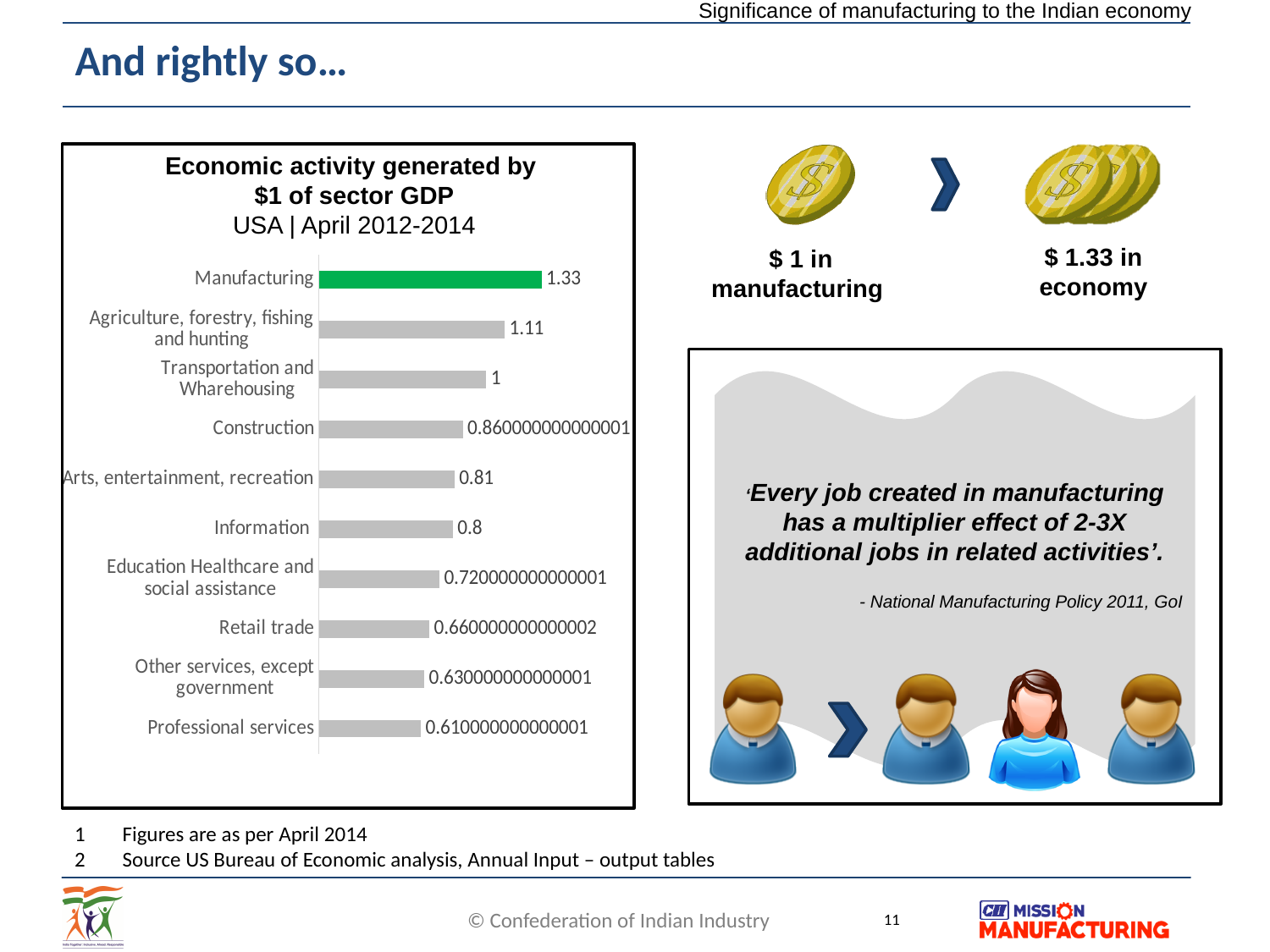
What is the difference between the values for Manufacturing and Agriculture, forestry, fishing and hunting? 0.22 What value is shown for Transportation and Wharehousing? 1 What is the economic activity generated by $1 of sector GDP for Manufacturing? 1.33 Which sector has the highest economic activity generated by $1 of sector GDP? Manufacturing What value is shown for Agriculture, forestry, fishing and hunting? 1.11 What value is shown for Information? 0.8 What type of chart is shown on the slide? Bar chart Which bar in the chart is coloured green rather than grey? Manufacturing Which sector has the lowest economic activity generated by $1 of sector GDP? Professional services What value is shown for Construction? 0.860000000000001 Which has a larger value, Retail trade or Arts, entertainment, recreation? Arts, entertainment, recreation How many sectors are shown in the chart? 10